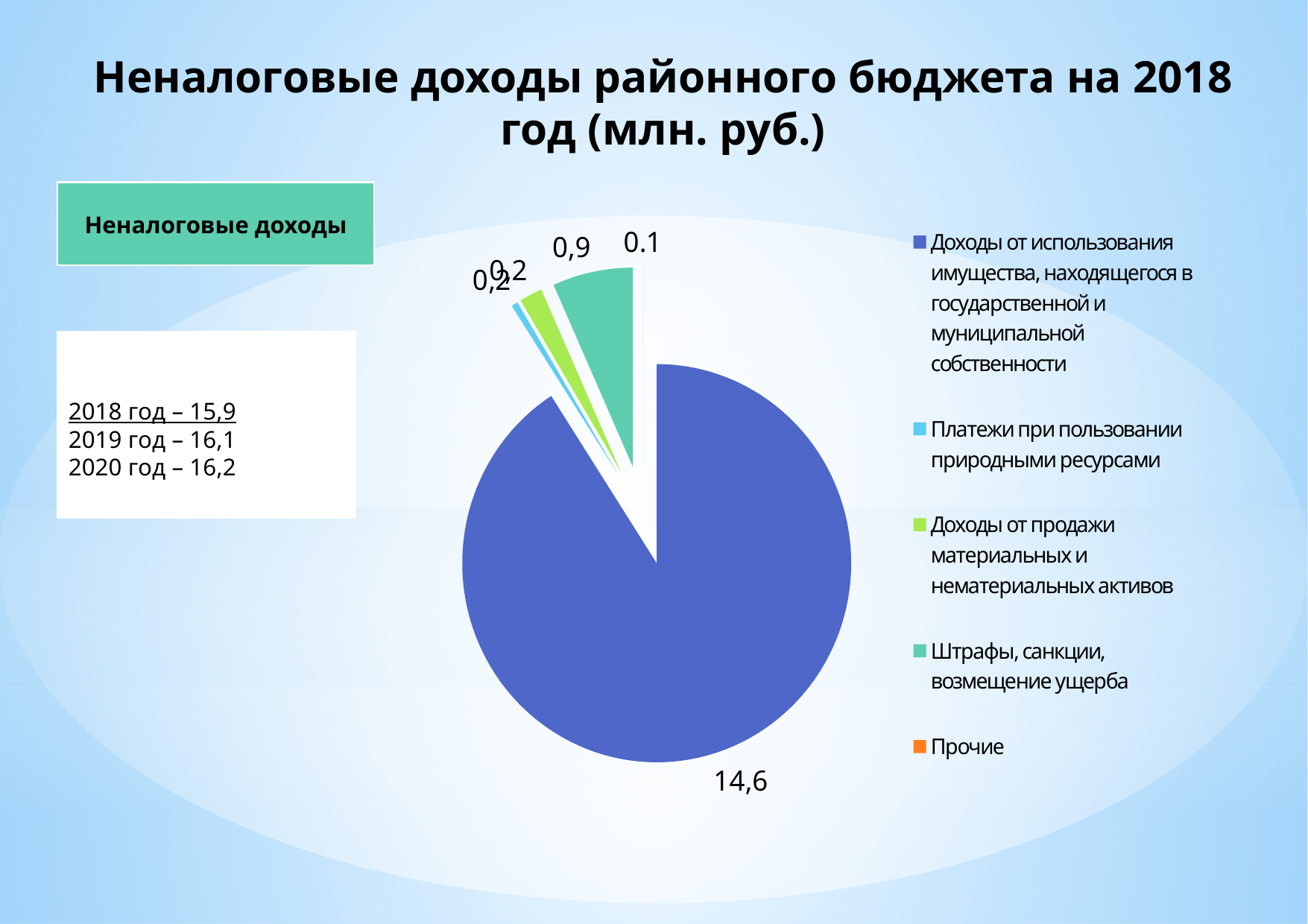
How many categories does the legend of the pie chart list? 5 What kind of chart is shown on the slide? Pie chart What is the difference between the value for «Доходы от использования имущества» (14,6) and «Штрафы, санкции, возмещение ущерба» (0,9)? 13,7 Which is larger: «Штрафы, санкции, возмещение ущерба» or «Платежи при пользовании природными ресурсами»? Штрафы, санкции, возмещение ущерба What colour is the largest slice of the pie chart? Blue What is the value for «Доходы от использования имущества, находящегося в государственной и муниципальной собственности»? 14,6 What is the value for «Штрафы, санкции, возмещение ущерба»? 0,9 What is the title of the slide containing the pie chart? Неналоговые доходы районного бюджета на 2018 год (млн. руб.) Which category has the largest slice of the pie? Доходы от использования имущества, находящегося в государственной и муниципальной собственности Which is larger: «Доходы от использования имущества» or «Штрафы, санкции, возмещение ущерба»? Доходы от использования имущества